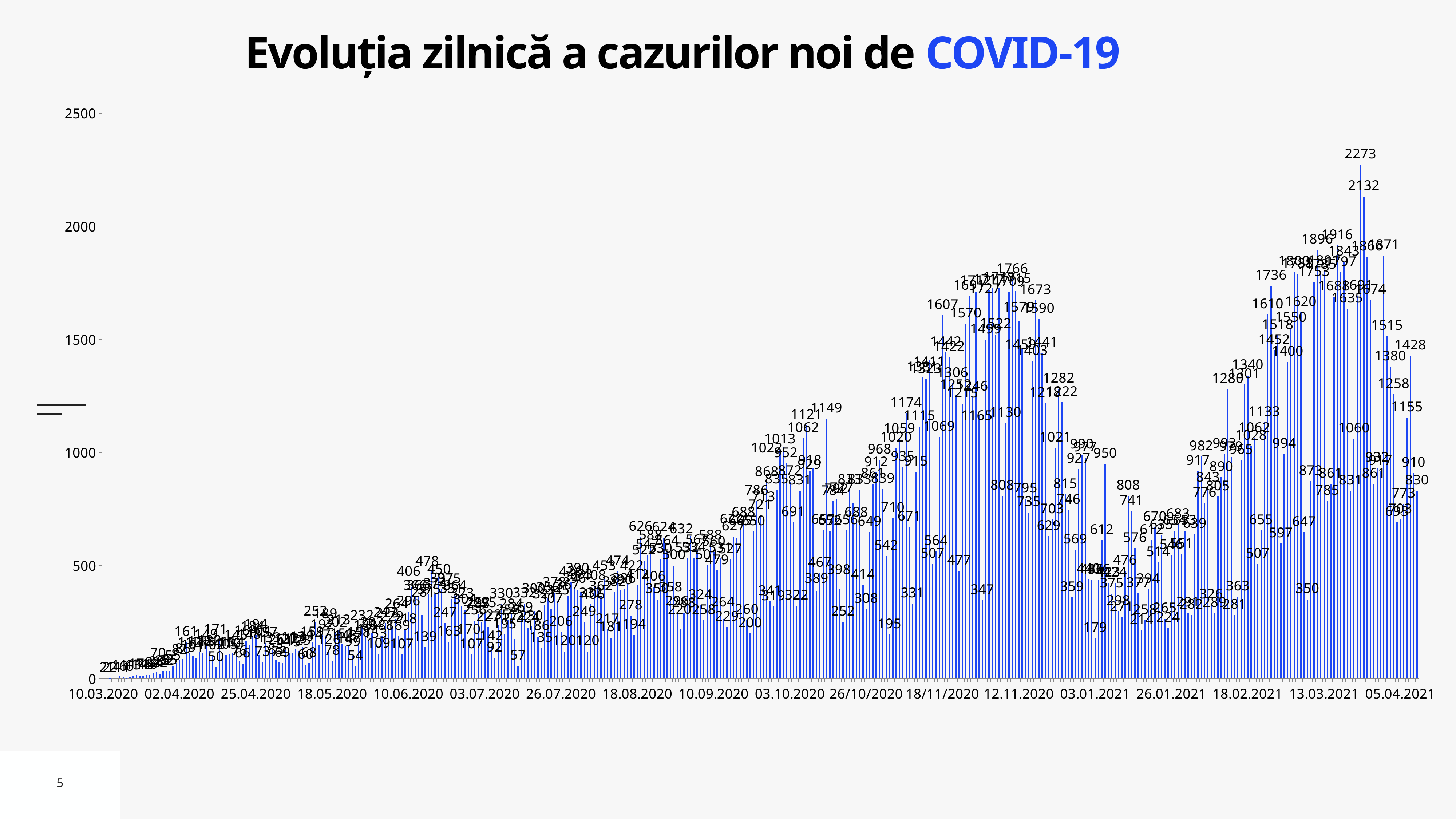
What is the highest daily value labelled on the chart? 2273 What is the second highest value labelled on the chart, next to the 2273 peak? 2132 Are the values at the start of the chart, around 10.03.2020, greater or less than 500? less What is the first date label on the horizontal axis? 10.03.2020 What is the title of the chart? Evoluția zilnică a cazurilor noi de COVID-19 What is the difference between the two highest labelled values, 2273 and 2132? 141 Is the highest bar on the chart greater or less than 2000? greater What is the last date label on the horizontal axis? 05.04.2021 What kind of chart is shown on the slide? bar chart What is the highest value shown on the vertical axis? 2500 Is the highest peak in the 2021 part of the chart larger or smaller than the highest peak in November 2020? larger How many date labels are shown on the horizontal axis? 18